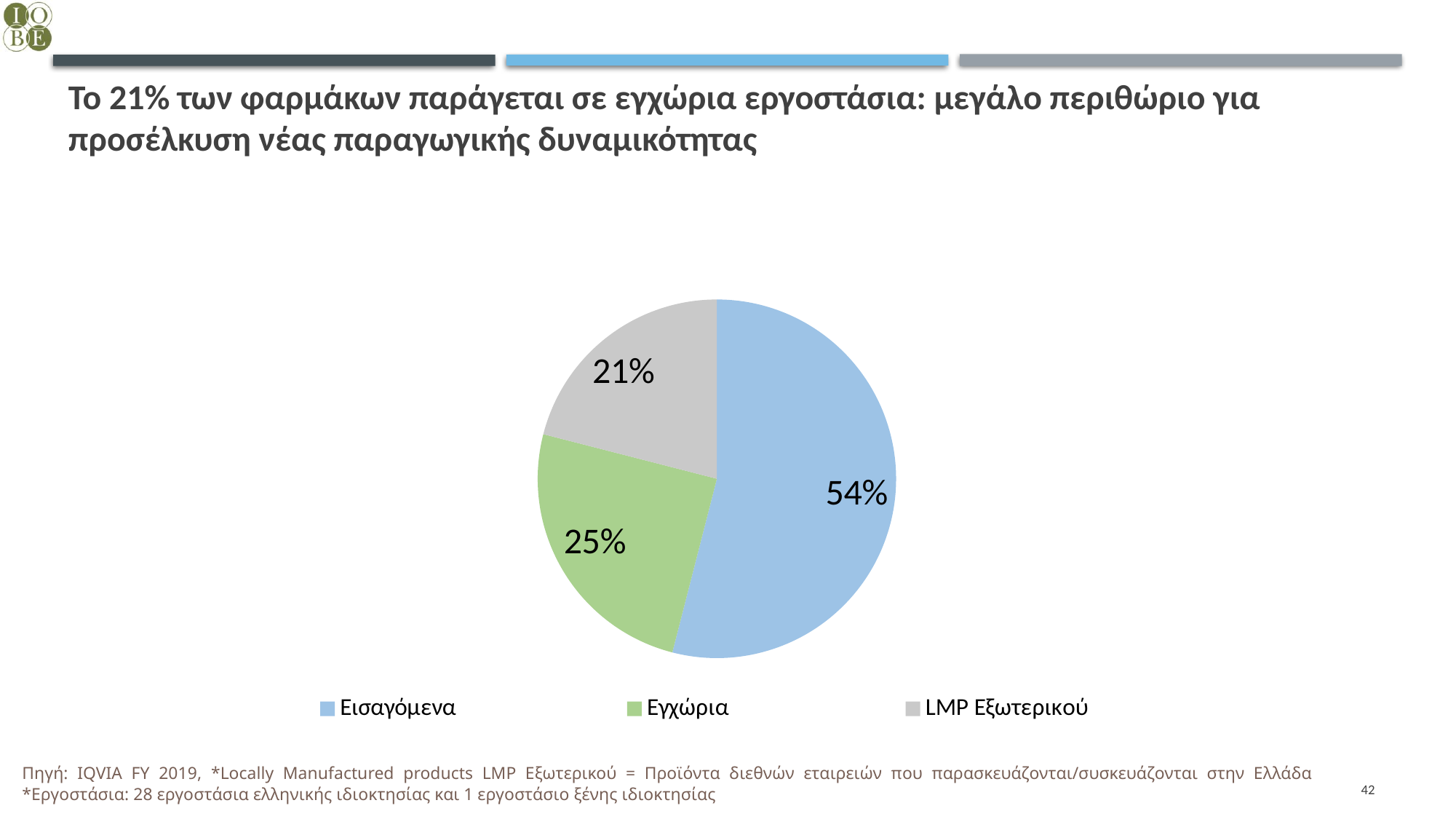
Which is larger, the share for Εγχώρια or the share for LMP Εξωτερικού? Εγχώρια How many entries does the legend list? 3 How many slices does the pie chart have? 3 What share of the pie does Εισαγόμενα hold? 54% What kind of chart is shown on the slide? pie chart What is the difference in percentage points between Εισαγόμενα and Εγχώρια? 29 What is the difference in percentage points between Εγχώρια and LMP Εξωτερικού? 4 What share of the pie does Εγχώρια hold? 25% What colour is the slice for Εγχώρια? green Which category has the largest slice of the pie? Εισαγόμενα Which category has the smallest slice of the pie? LMP Εξωτερικού What share of the pie does LMP Εξωτερικού hold? 21%